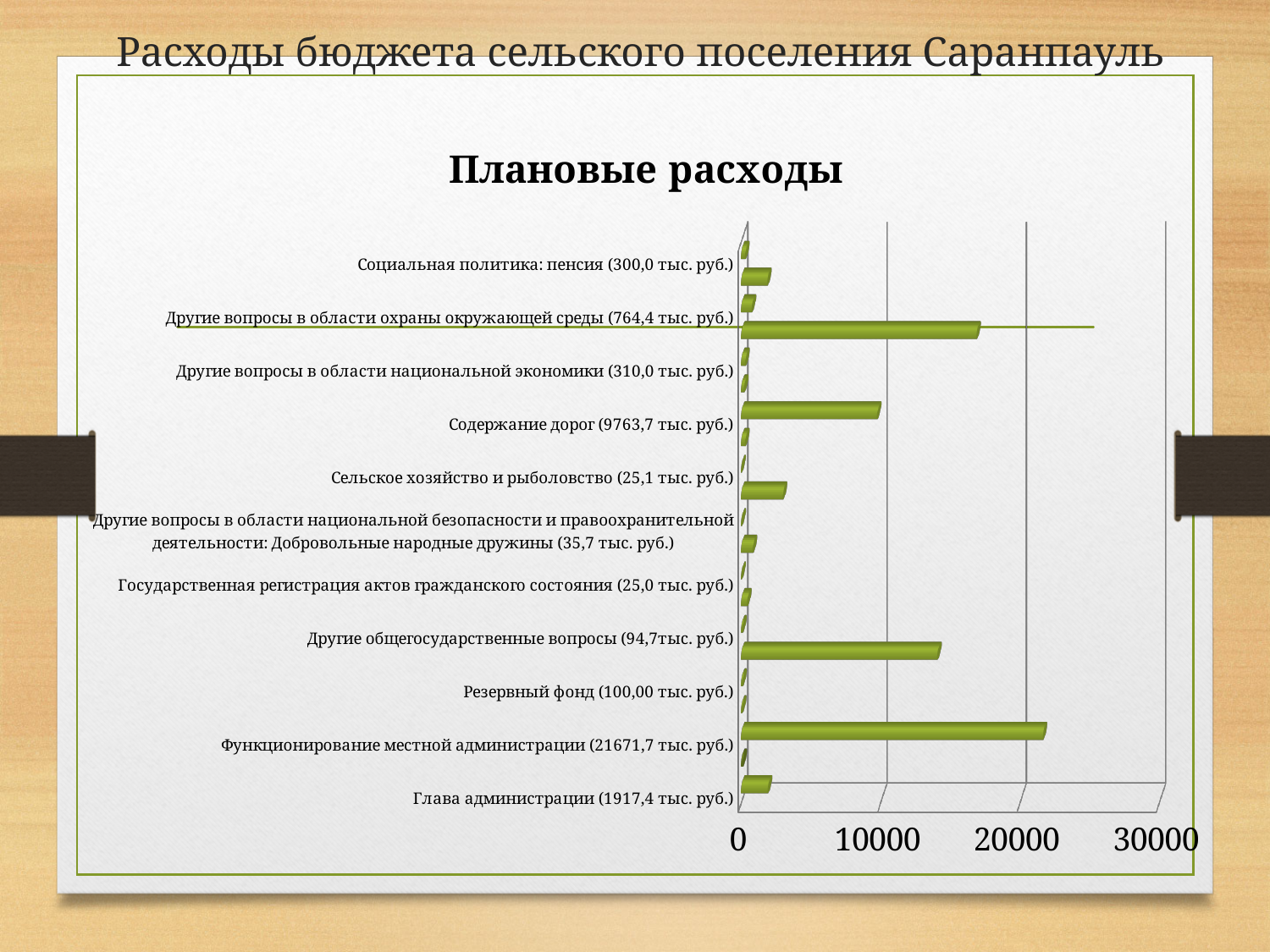
What is the highest value shown on the horizontal axis? 30000 Is the value for Функционирование местной администрации greater or less than 20000? greater Which category has the longest bar in the chart? Функционирование местной администрации (21671,7 тыс. руб.) What amount is printed in the category label for Глава администрации? 1917,4 тыс. руб. How many category labels are readable on the vertical axis of the chart? 11 What amount is printed in the category label for Содержание дорог? 9763,7 тыс. руб. Is the value for Глава администрации greater or less than 10000? less What amount is printed in the category label for Социальная политика: пенсия? 300,0 тыс. руб. According to the printed label amounts, which is larger: Содержание дорог or Глава администрации? Содержание дорог What is the title of the chart? Плановые расходы What kind of chart is shown on the slide? bar chart What amount is printed in the category label for Резервный фонд? 100,00 тыс. руб.